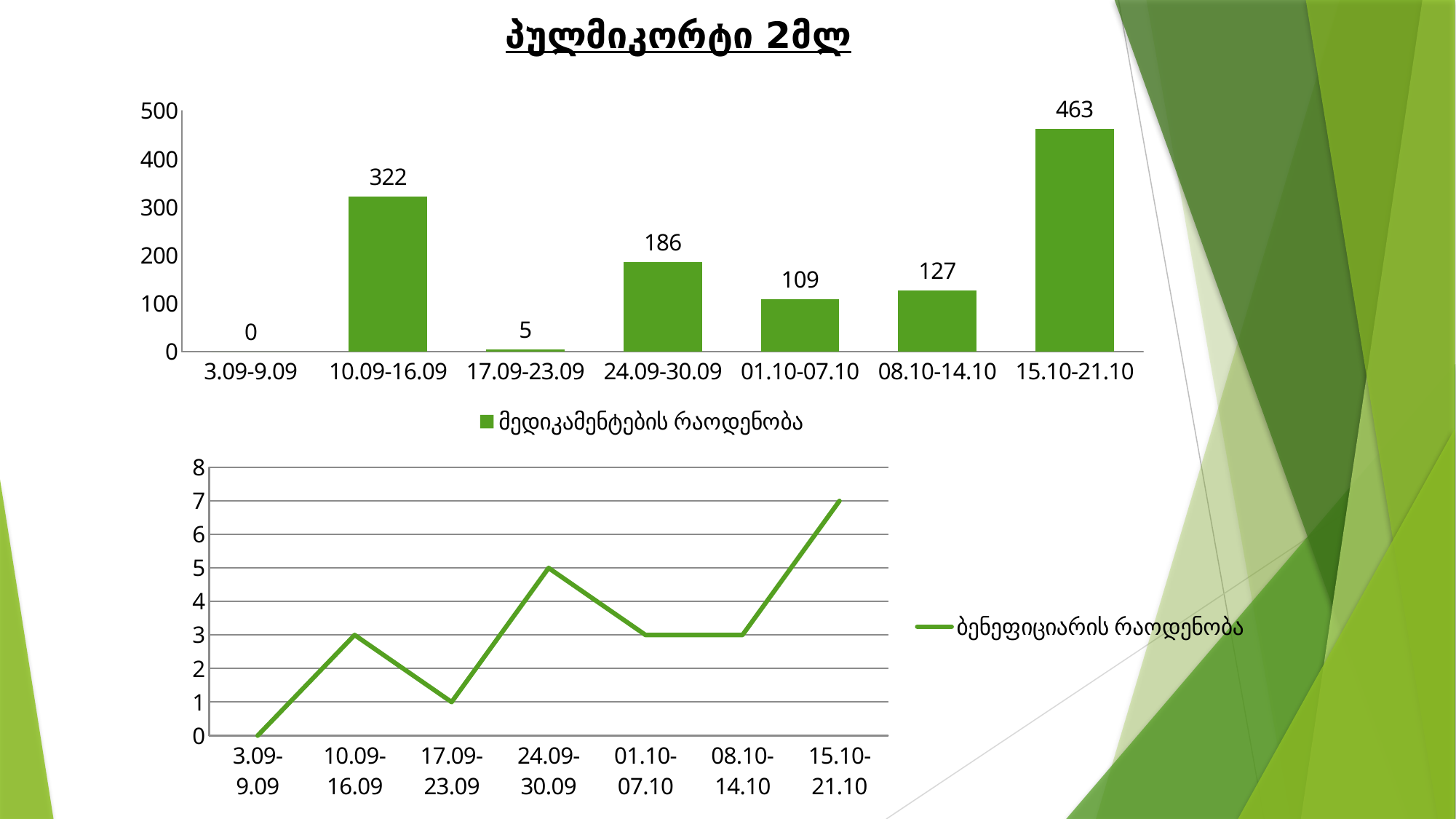
In the bottom line chart, what is the value for 24.09-30.09? 5 In the bottom line chart, which period has the highest value? 15.10-21.10 In the top bar chart, what is the value for 24.09-30.09? 186 In the top bar chart, which period has the highest value? 15.10-21.10 How many periods are shown on the x axis of the top bar chart? 7 In the top bar chart, what is the value for 15.10-21.10? 463 What is the legend entry of the bottom line chart? ბენეფიციარის რაოდენობა What type of chart is the bottom chart on the slide? Line chart In the top bar chart, which period has the lowest value? 3.09-9.09 In the top bar chart, what is the difference between the values for 10.09-16.09 and 08.10-14.10? 195 In the top bar chart, which is larger: the value for 01.10-07.10 or the value for 08.10-14.10? 08.10-14.10 In the bottom line chart, is the value for 10.09-16.09 greater or less than 2? greater